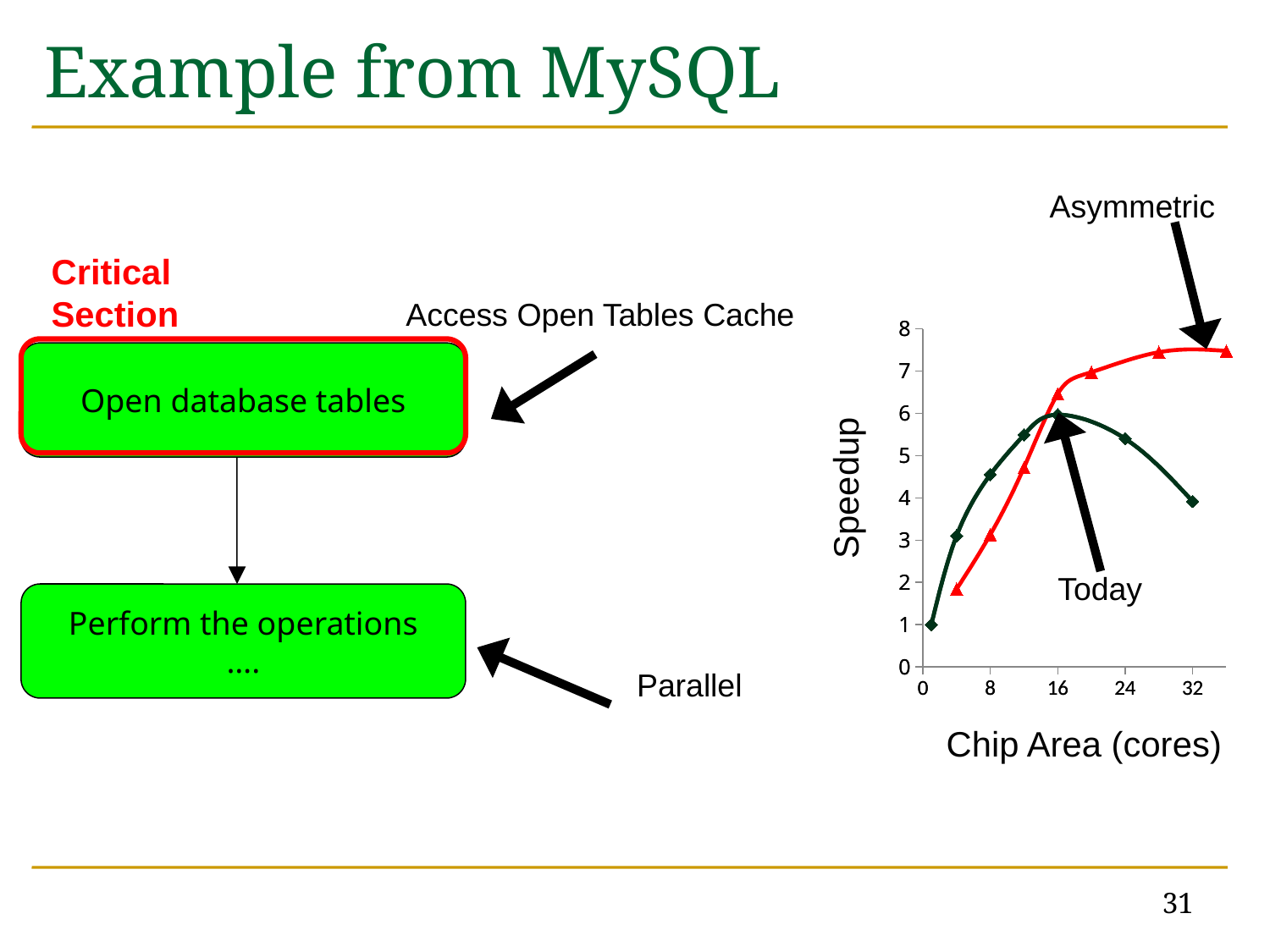
In the Speedup chart, is the Asymmetric speedup at 32 cores greater or less than 7? greater How many lines are plotted in the Speedup chart? 2 What kind of chart is shown on the right of the slide? line chart In the Speedup chart, which line has the higher speedup at 32 cores, Asymmetric or Today? Asymmetric In the Speedup chart, is the Today speedup at 32 cores greater or less than 5? less In the Speedup chart, which line has the higher speedup at 8 cores, Asymmetric or Today? Today In the Speedup chart, is the Asymmetric speedup at 4 cores greater or less than 3? less What is the label of the y axis of the chart on the right? Speedup In the Speedup chart, does the Today line rise or fall between 16 and 32 cores? fall In the Speedup chart, does the Asymmetric line rise or fall between 0 and 16 cores? rise What is the label of the x axis of the Speedup chart? Chip Area (cores)